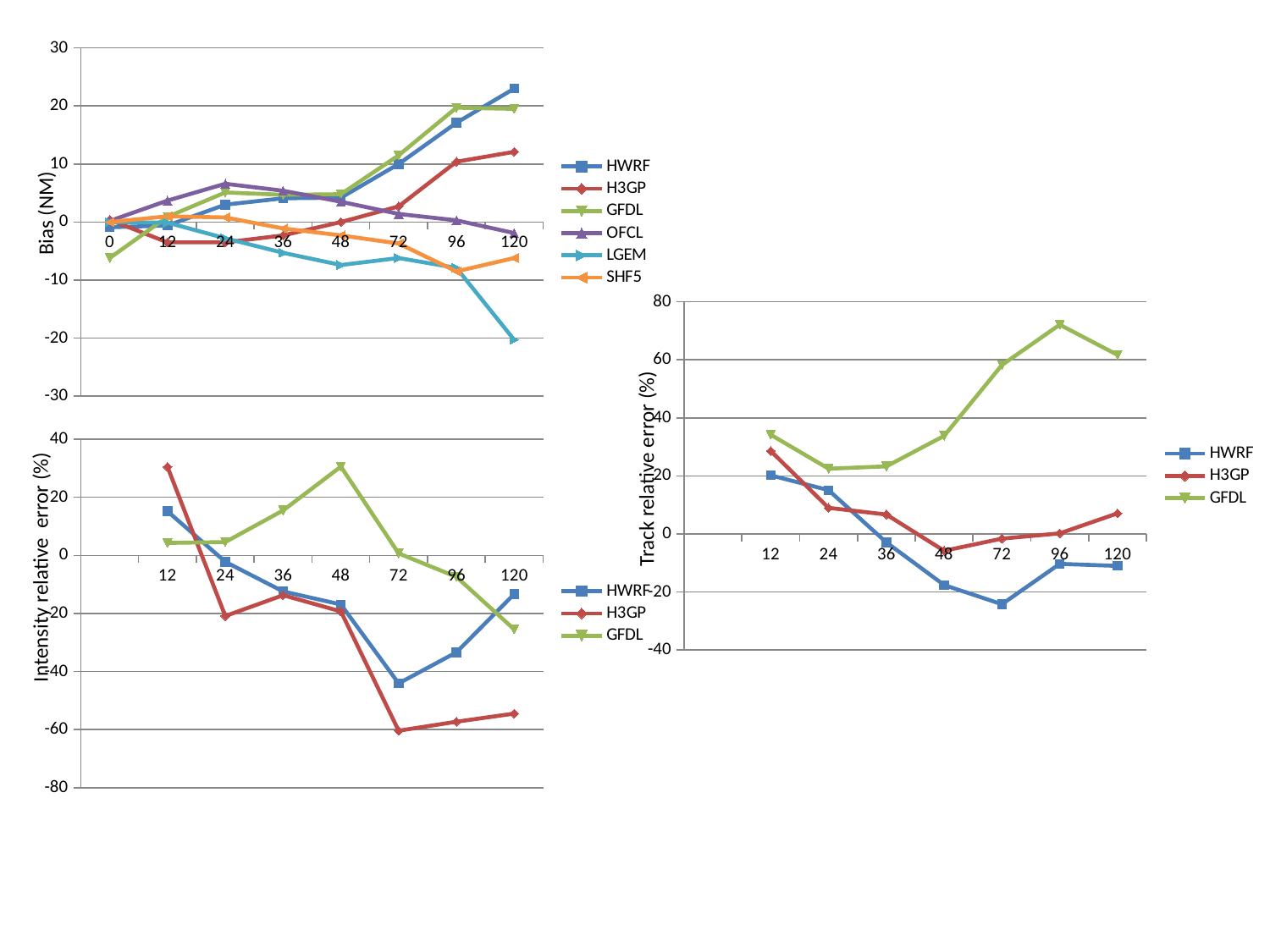
In the top-left Bias (NM) chart, is the value for HWRF at 120 greater or less than 20? greater In the top-left Bias (NM) chart, how many points are on the x axis? 8 In the right-hand Track relative error (%) chart, does the GFDL line rise or fall from 36 to 96? rise What kind of chart is the top-left chart with the y-axis labelled Bias (NM)? line chart In the bottom-left Intensity relative error (%) chart, how many series does the legend list? 3 In the bottom-left Intensity relative error (%) chart, which series has the lowest value at 72? H3GP In the right-hand Track relative error (%) chart, which series has the highest value at 96? GFDL In the top-left Bias (NM) chart, which series has the lowest value at 120? LGEM In the bottom-left Intensity relative error (%) chart, is the value for GFDL at 48 greater or less than 20? greater In the top-left Bias (NM) chart, how many series does the legend list? 6 In the bottom-left Intensity relative error (%) chart, which is larger at 12: HWRF or H3GP? H3GP In the top-left Bias (NM) chart, which series has the highest value at 120? HWRF